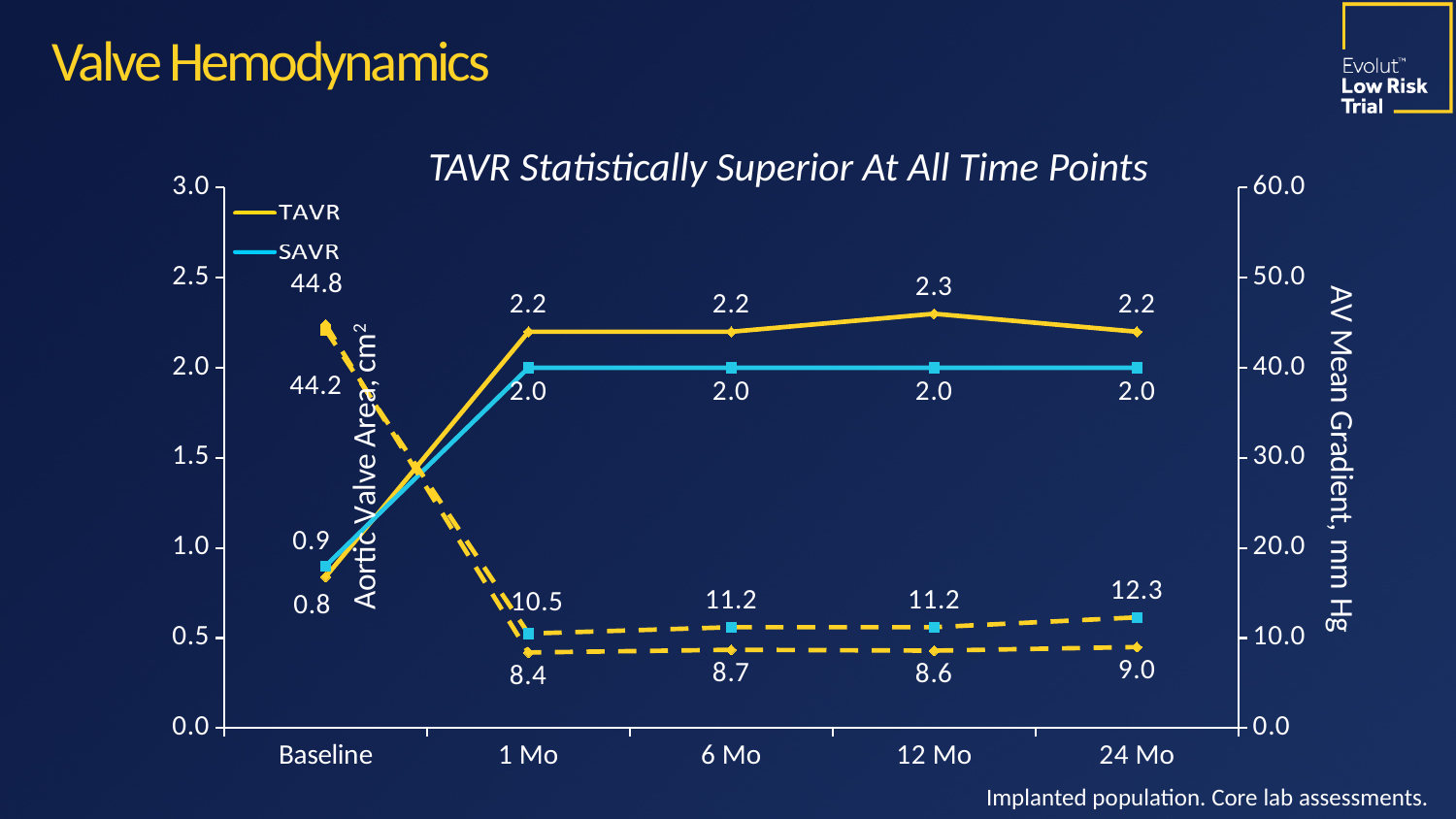
How many time points are shown on the x axis? 5 What is the SAVR AV mean gradient at 24 Mo (dashed line with square markers)? 12.3 What is the TAVR aortic valve area at Baseline? 0.8 What is the TAVR AV mean gradient at 1 Mo (dashed line with diamond markers)? 8.4 At which time point is the TAVR aortic valve area highest? 12 Mo How many series does the legend list? 2 What is the SAVR aortic valve area at 24 Mo? 2.0 Which is larger at 24 Mo, the TAVR aortic valve area or the SAVR aortic valve area? TAVR What is the TAVR aortic valve area at 12 Mo? 2.3 What is the subtitle shown above the chart? TAVR Statistically Superior At All Time Points What is the difference between the TAVR and SAVR aortic valve area at 6 Mo? 0.2 What kind of chart is shown on the slide? Line chart